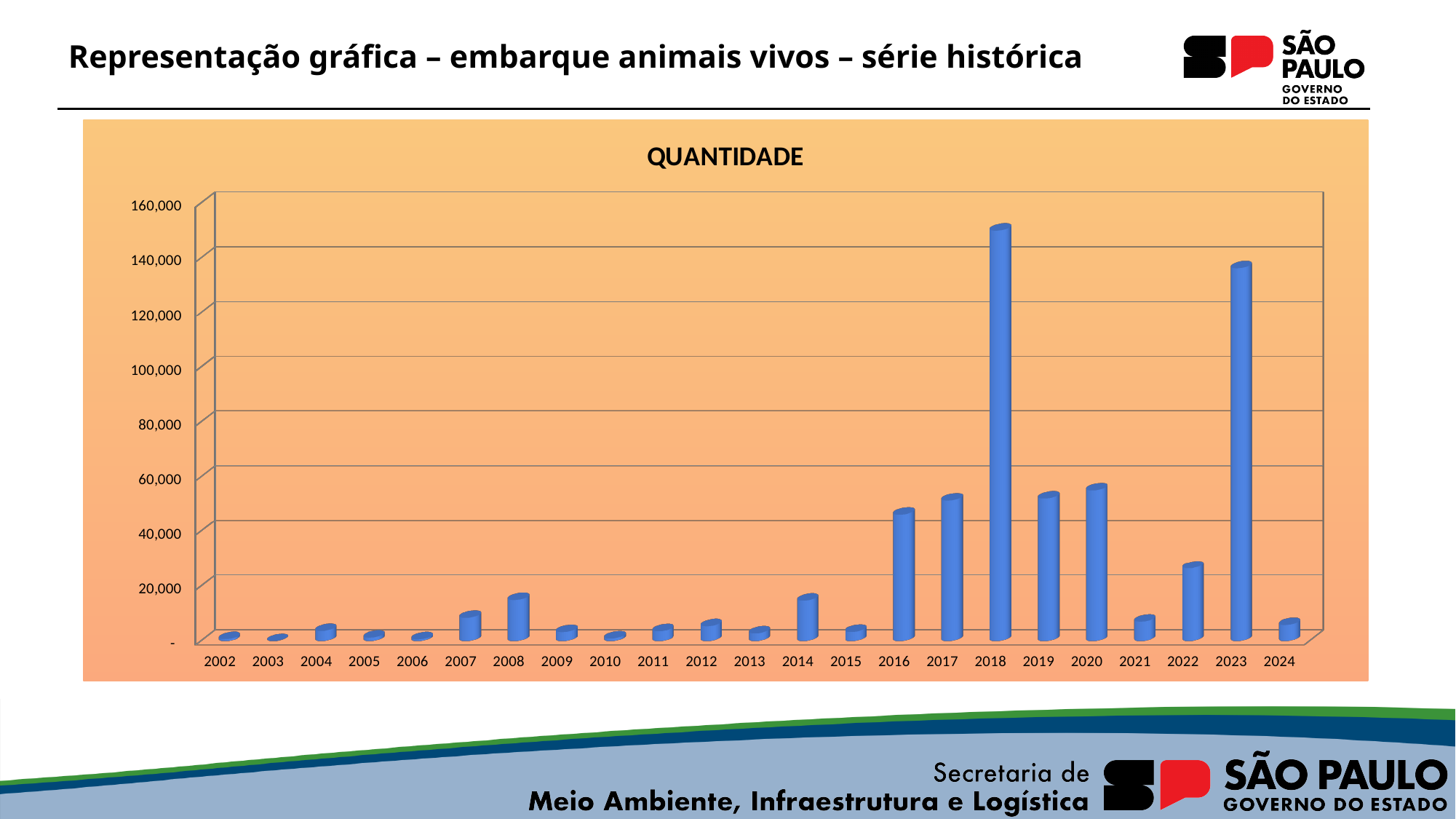
Which year has the larger value, 2021 or 2022? 2022 What kind of chart is shown on the slide? bar chart Is the value for 2018 greater or less than 140,000? greater Which year has the larger value, 2016 or 2020? 2020 How many years are shown on the x axis of the chart? 23 Is the value for 2008 greater or less than 20,000? less What is the title of the chart? QUANTIDADE Is the value for 2022 greater or less than 20,000? greater Which year has the larger value, 2018 or 2023? 2018 Which year has the highest value in the chart? 2018